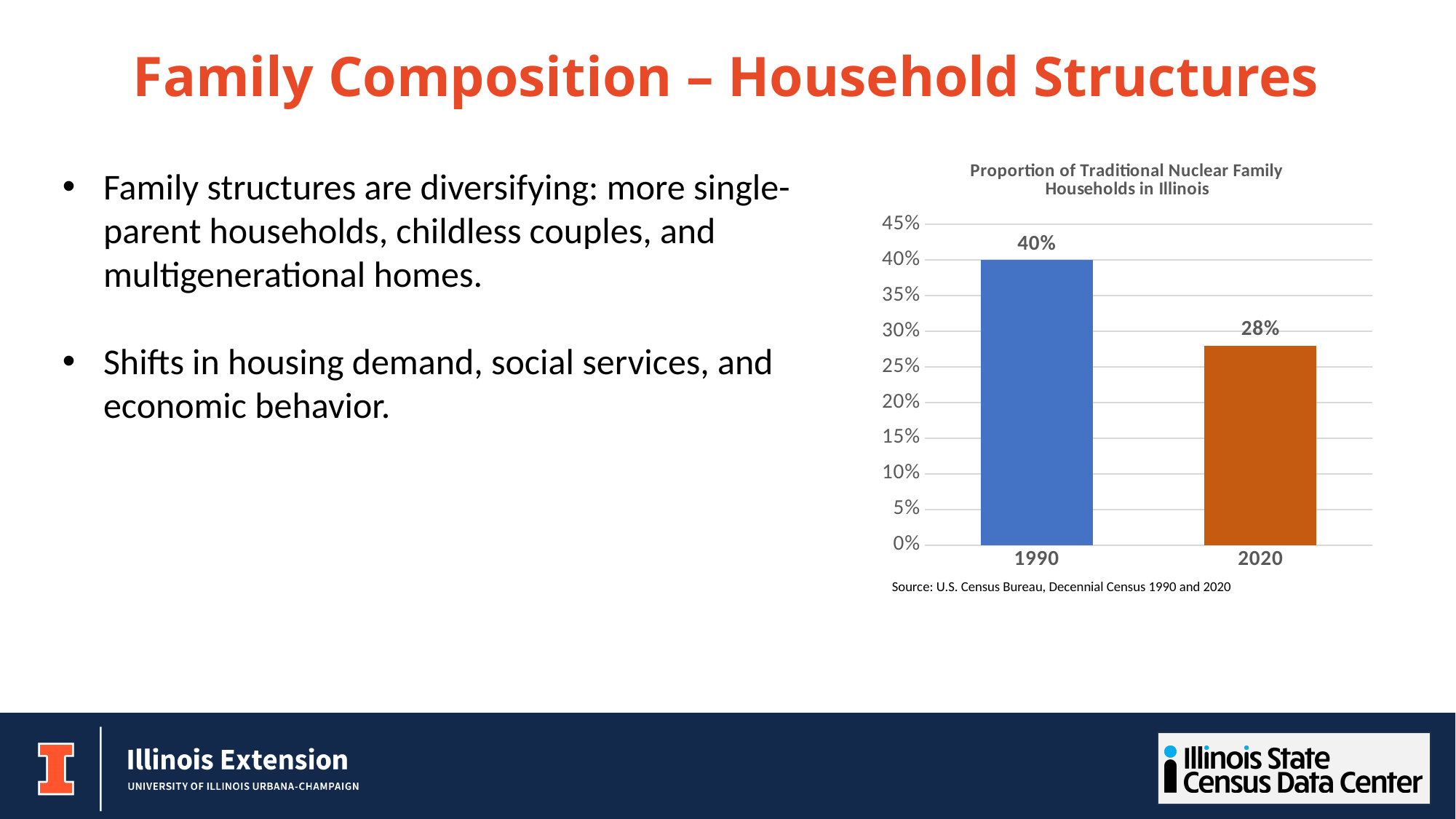
By how many percentage points did the proportion of traditional nuclear family households fall from 1990 to 2020? 12 percentage points Which year has the higher proportion of traditional nuclear family households? 1990 What kind of chart is shown on the slide? bar chart Is the value for 1990 larger or smaller than the value for 2020? larger Is the value for 2020 greater or less than 30%? less What colour is the bar for 2020? orange What is the proportion of traditional nuclear family households in Illinois in 2020? 28% Does the proportion of traditional nuclear family households rise or fall from 1990 to 2020? fall Which year has the lower proportion of traditional nuclear family households? 2020 How many years are shown on the chart? 2 What is the title of the chart? Proportion of Traditional Nuclear Family Households in Illinois What is the proportion of traditional nuclear family households in Illinois in 1990? 40%